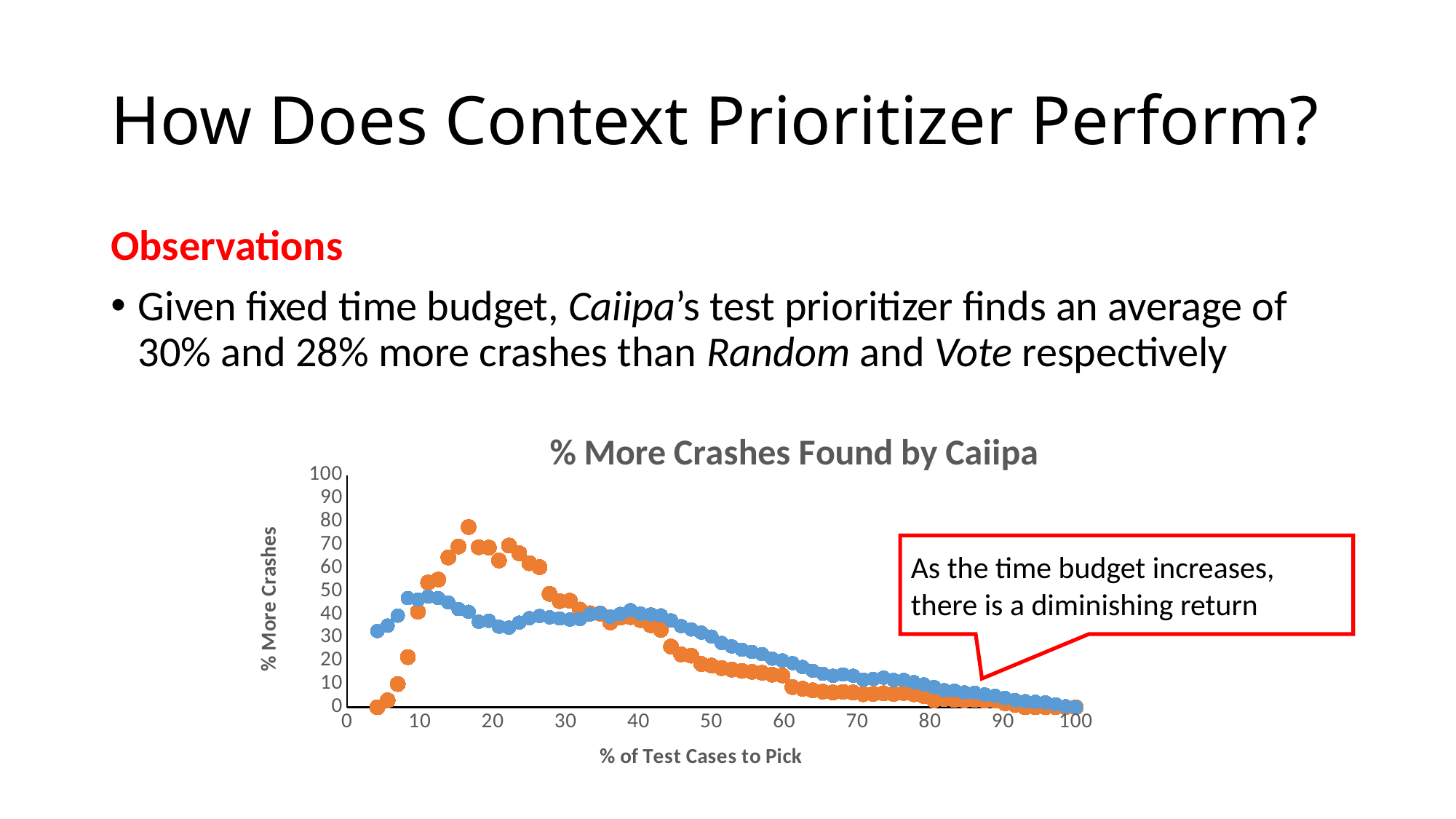
What kind of chart is shown on the slide? Scatter plot Is the value of the orange series at about 5% of test cases greater or less than 10? less Which series reaches the highest value anywhere in the chart, orange or blue? orange Is the peak value of the orange series greater or less than 70? greater From 40% to 100% of test cases, do the values of both series rise or fall? fall What is the label of the x axis of the chart? % of Test Cases to Pick How many data series are plotted in the chart? 2 At 20% of test cases, which series has the higher value, orange or blue? orange Is the value of the blue series at 100% of test cases greater or less than 10? less What is the title of the chart? % More Crashes Found by Caiipa At 60% of test cases, which series has the higher value, orange or blue? blue